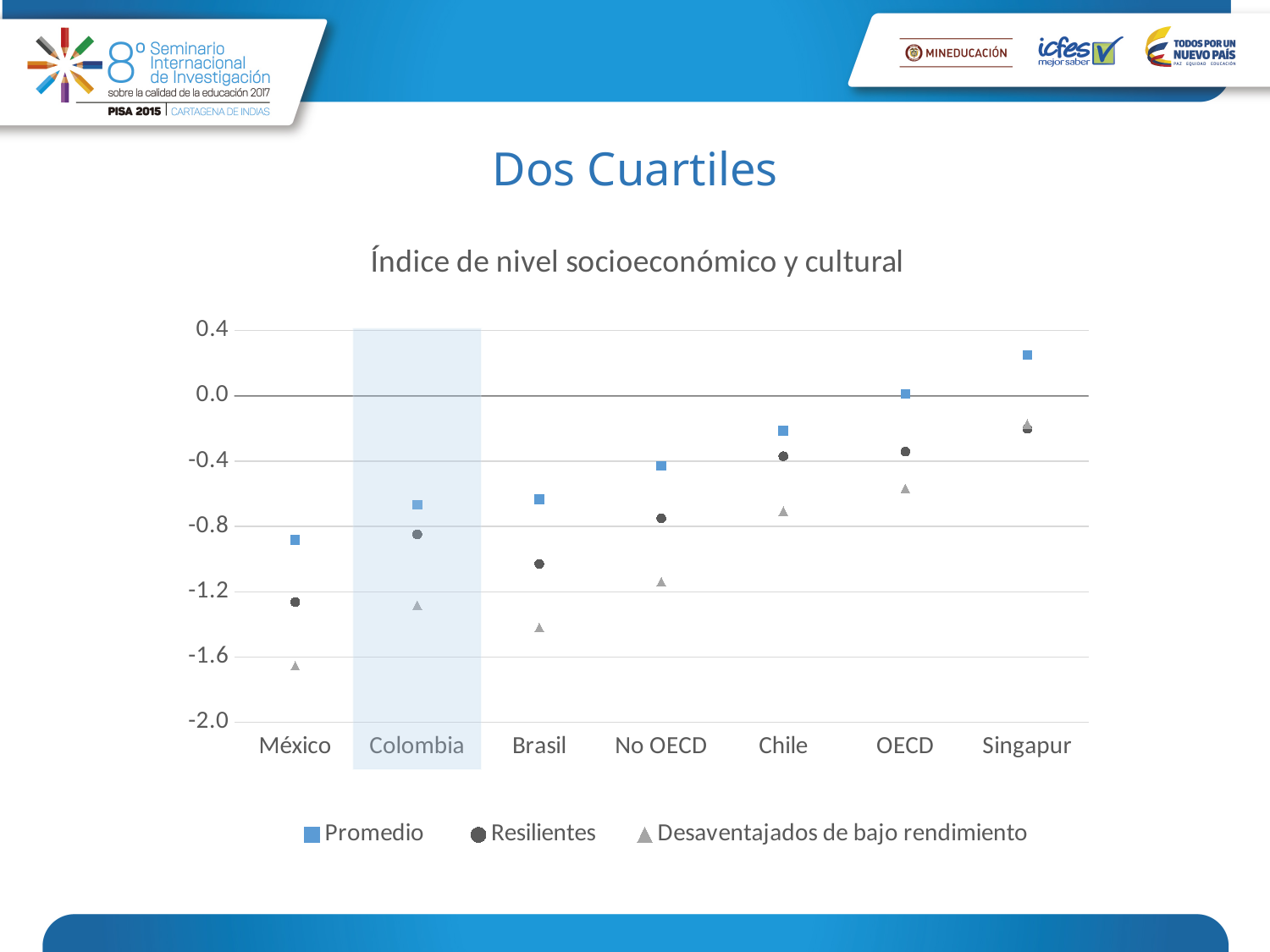
Which category has the lowest value for Desaventajados de bajo rendimiento? México Do the Promedio values rise or fall from México to Singapur along the x axis? rise How many categories are shown on the x axis? 7 What kind of chart is shown on the slide? scatter chart Is the Promedio value for Singapur greater or less than 0.0? greater Which has the higher Resilientes value, Colombia or Brasil? Colombia Which category is highlighted with a shaded band on the chart? Colombia Which category has the lowest Promedio value? México Is the Promedio value for Chile greater or less than -0.4? greater Which category has the highest Promedio value? Singapur How many series does the legend list? 3 Is the Desaventajados de bajo rendimiento value for Brasil greater or less than -1.2? less